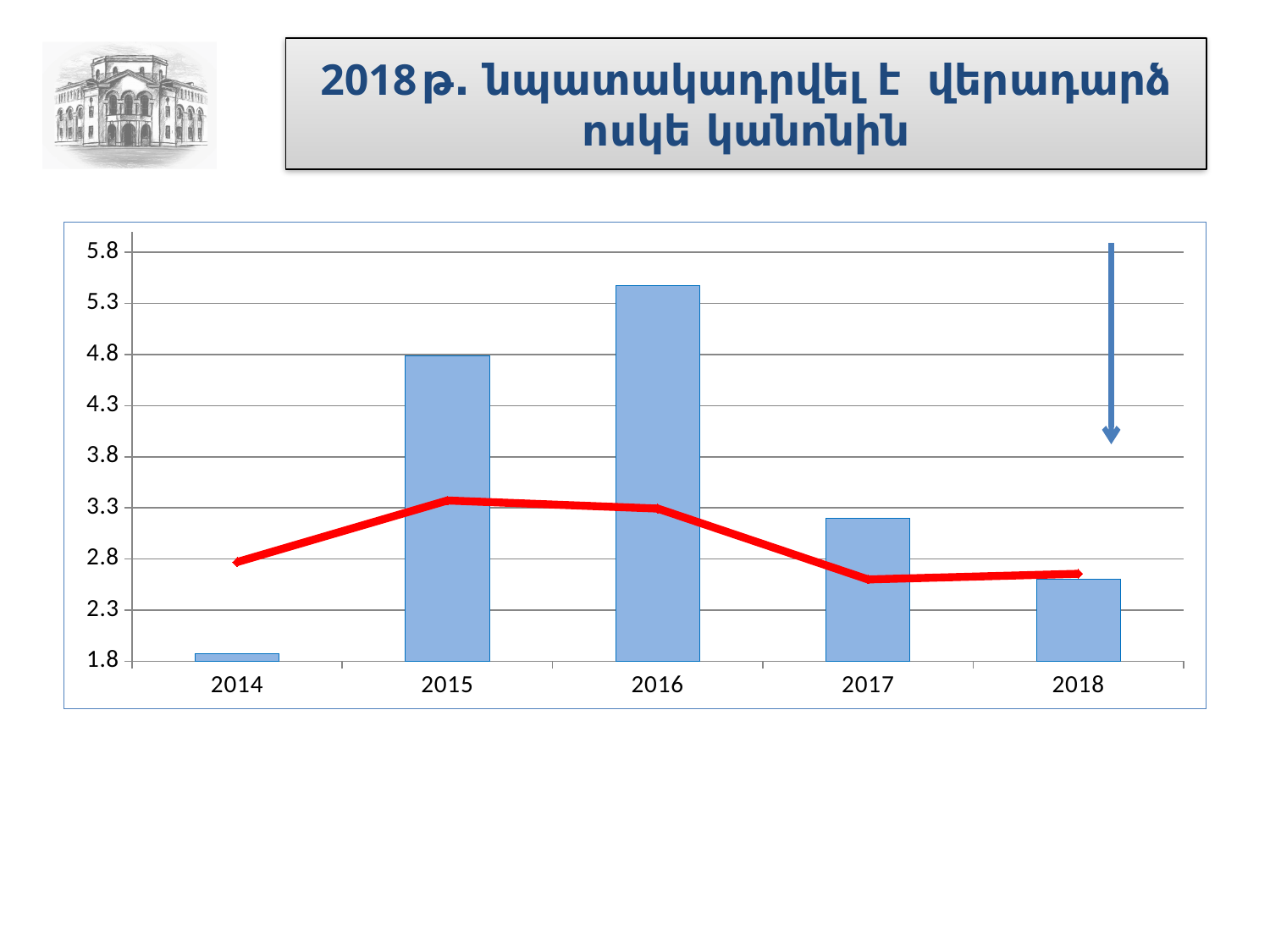
Which year has the tallest bar? 2016 Is the bar for 2014 greater or less than 2.3? less Which year has the shortest bar? 2014 Which bar is taller, 2015 or 2016? 2016 Do the bars rise or fall from 2016 to 2018? fall Which bar is taller, 2017 or 2018? 2017 What colour is the line plotted over the bars? red Is the bar for 2018 greater or less than 2.8? less Is the bar for 2017 greater or less than 2.8? greater How many years are shown on the x axis? 5